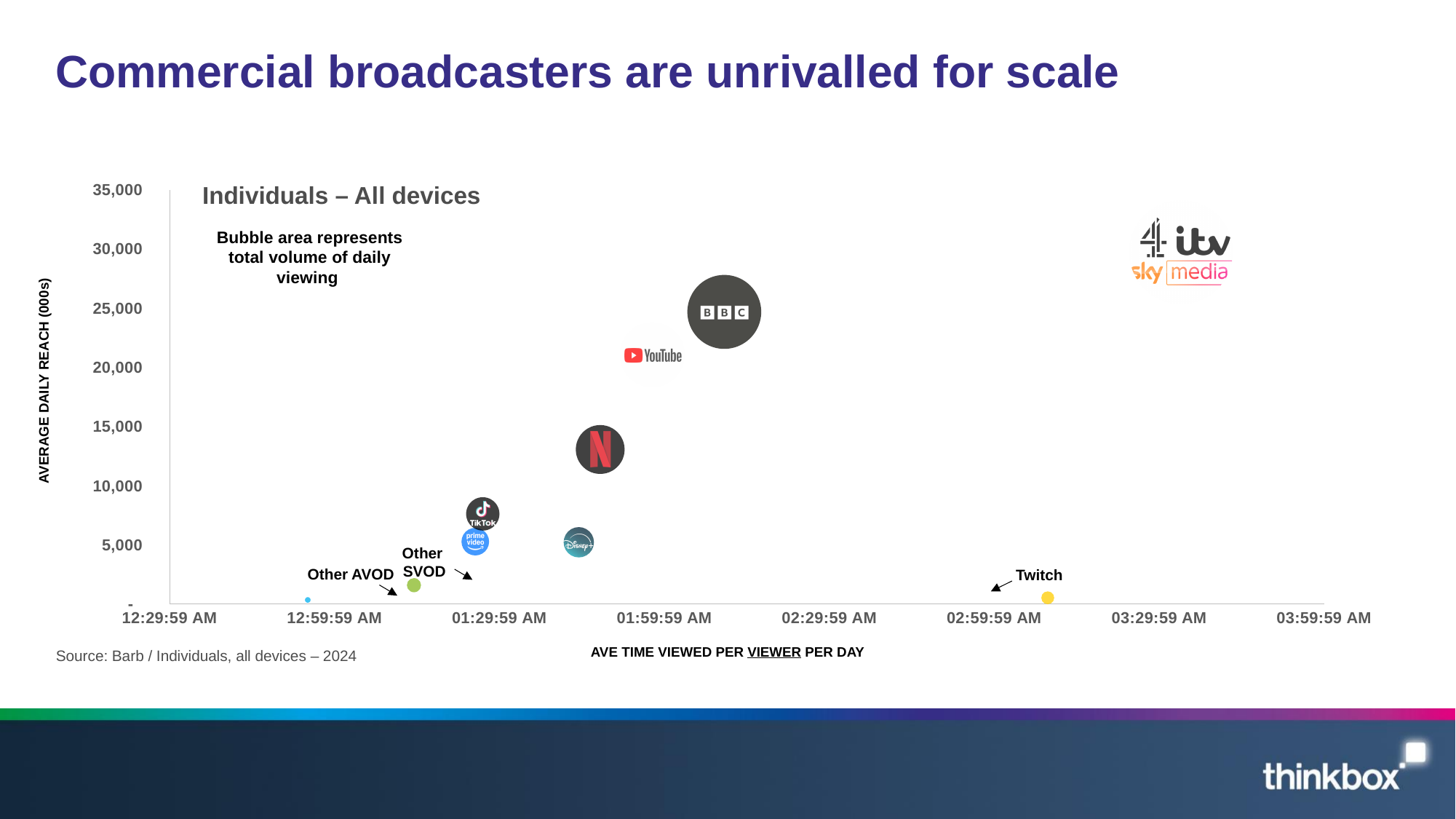
Which has the higher average daily reach, BBC or Netflix? BBC Is the average daily reach for YouTube greater or less than 15,000? greater Which has the higher average time viewed per viewer per day, BBC or TikTok? BBC Which has the higher average daily reach, TikTok or Other SVOD? TikTok What kind of chart is shown on the slide? Bubble chart Is the average daily reach for Disney+ greater or less than 10,000? less What is the label of the vertical axis of the chart? AVERAGE DAILY REACH (000s) Is the average daily reach for Twitch greater or less than 5,000? less According to the note on the chart, what does the bubble area represent? Total volume of daily viewing